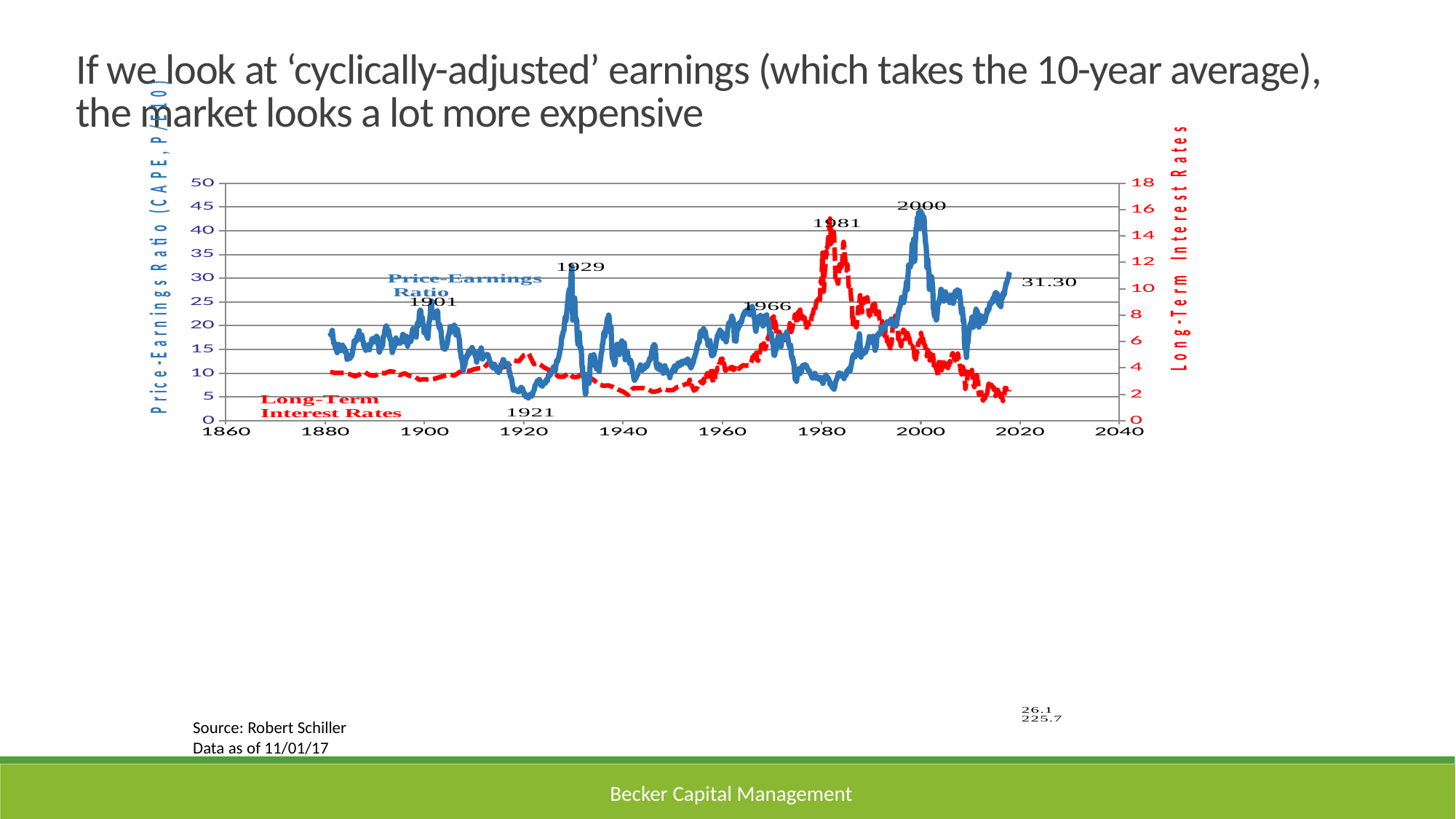
How many data series are plotted on the chart? 2 In which labeled year does the Price-Earnings Ratio reach its lowest point? 1921 What kind of chart is shown on the slide? line chart In which labeled year does the Price-Earnings Ratio reach its highest peak? 2000 Is the Long-Term Interest Rates peak in 1981 greater or less than 12 on the right axis? greater Which series is drawn as a red dashed line? Long-Term Interest Rates From the 1981 peak to 2017, do Long-Term Interest Rates generally rise or fall? fall What is the most recent Price-Earnings Ratio value labeled at the end of the blue line? 31.30 What is the label of the left vertical axis? Price-Earnings Ratio (CAPE, P/E10) Is the Price-Earnings Ratio at its 1921 low greater or less than 10? less Which peak of the Price-Earnings Ratio is higher, 1929 or 2000? 2000 Is the Price-Earnings Ratio peak in 2000 greater or less than 40? greater